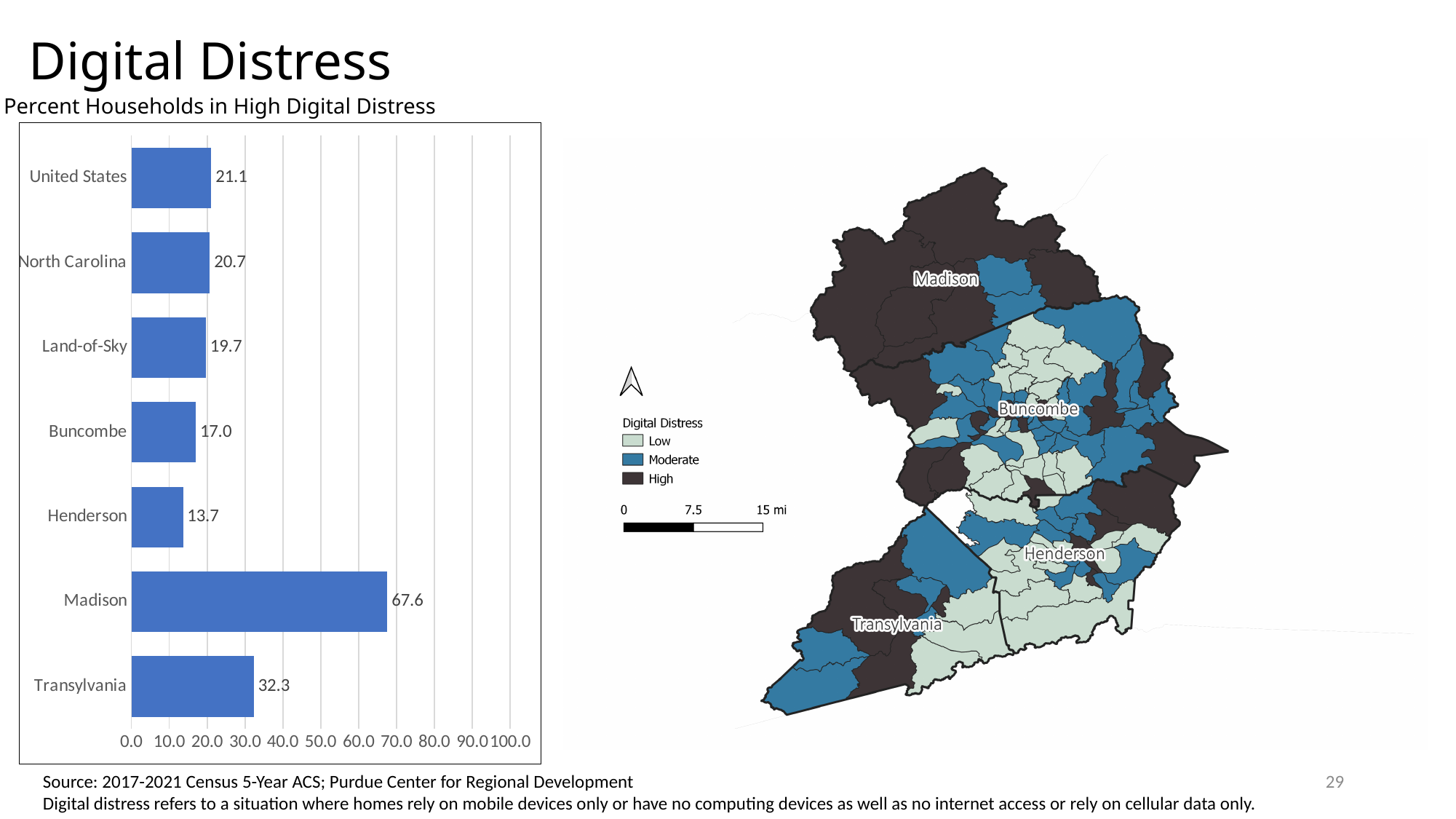
What is the difference between the values for North Carolina and Buncombe in the bar chart? 3.7 Which category has the lowest value in the bar chart? Henderson What is the value for Henderson in the bar chart? 13.7 What is the value for Madison in the Percent Households in High Digital Distress chart? 67.6 Which is larger in the bar chart, the value for Transylvania or the value for Buncombe? Transylvania How many levels of digital distress does the map legend list? 3 What is the difference between the values for Madison and Transylvania in the bar chart? 35.3 What kind of chart is used to show Percent Households in High Digital Distress? Bar chart What is the value for the United States in the bar chart? 21.1 What is the value for Land-of-Sky in the bar chart? 19.7 Which category has the highest value in the bar chart? Madison How many categories are shown in the bar chart? 7